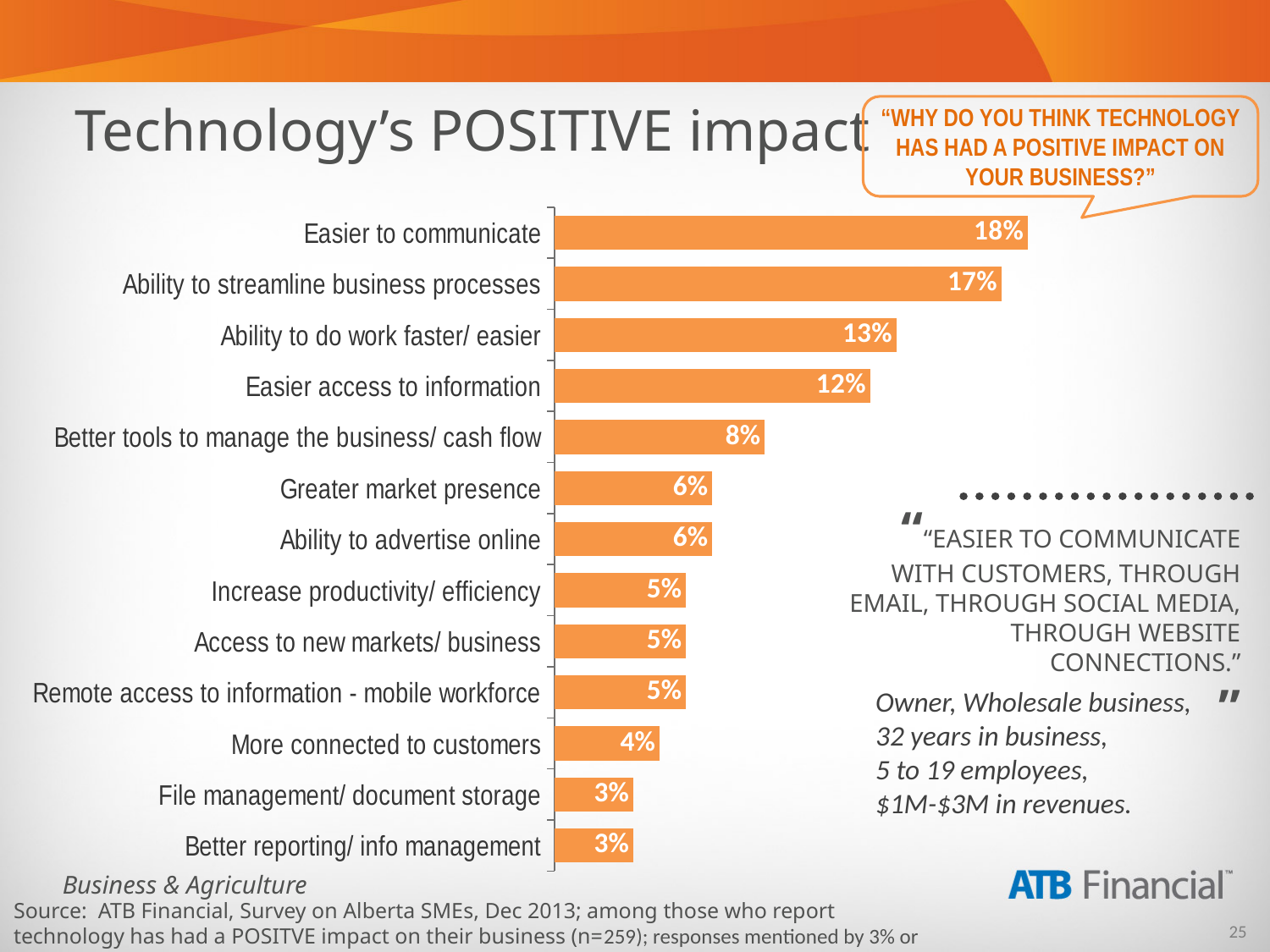
Which category has the highest value? Easier to communicate Which is larger, "Easier access to information" or "Greater market presence"? Easier access to information How many categories are shown in the chart? 13 What is the value for "More connected to customers"? 4% What is the difference between "Easier to communicate" and "Ability to streamline business processes"? 1% What percentage of respondents mentioned "Easier to communicate"? 18% What is the value for "Better reporting/ info management"? 3% What is the value for "Better tools to manage the business/ cash flow"? 8% What kind of chart is shown on the slide? Bar chart Which is larger, "Ability to advertise online" or "File management/ document storage"? Ability to advertise online How many categories have a value of 5%? 3 What is the difference between "Ability to do work faster/ easier" and "Better tools to manage the business/ cash flow"? 5%